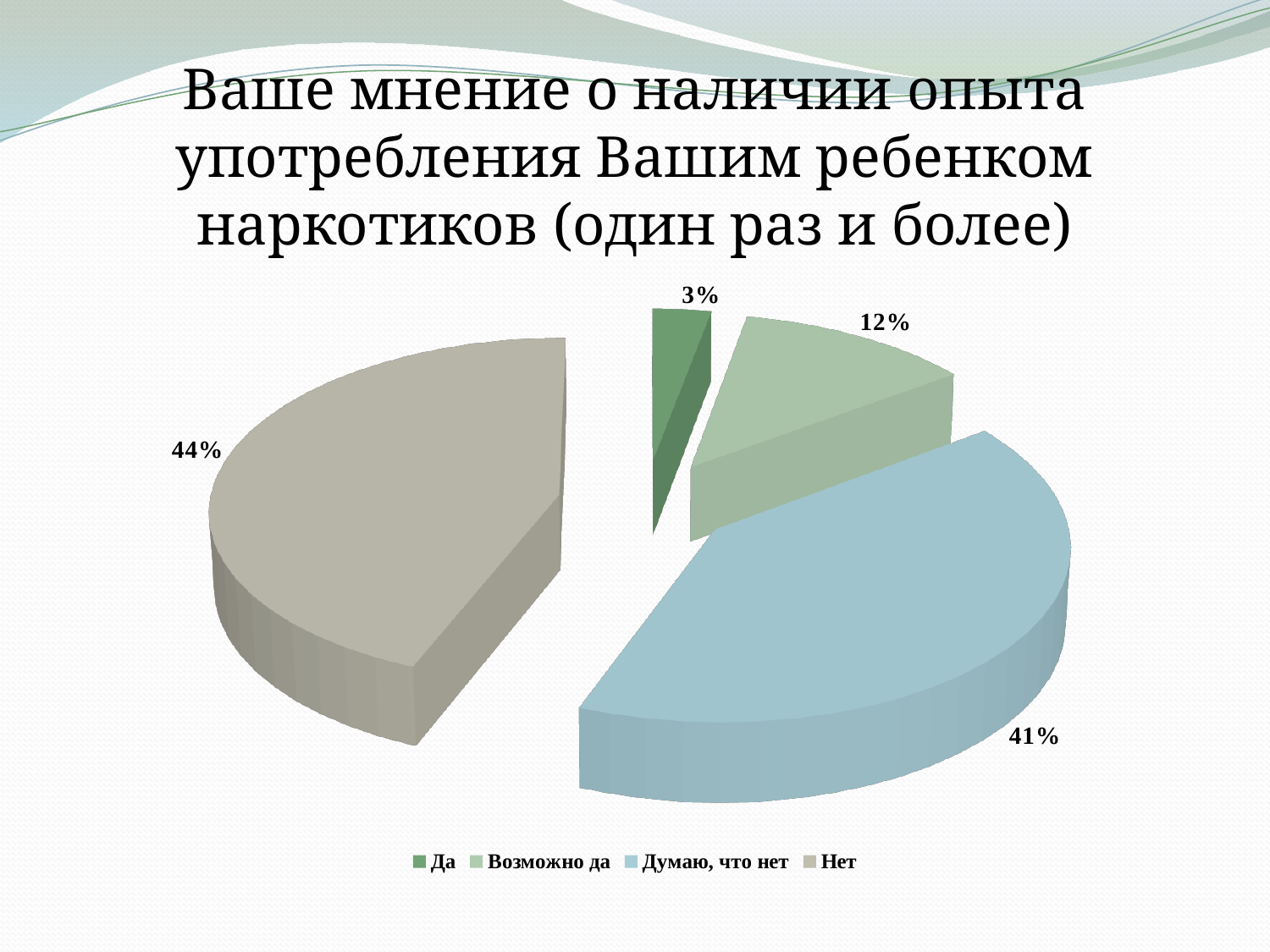
What share of the pie does the 'Возможно да' slice represent? 12% How many categories does the legend list? 4 What is the difference in percentage points between the 'Возможно да' and 'Да' slices? 9% Which category has the smallest slice of the pie? Да What share of the pie does the 'Думаю, что нет' slice represent? 41% What colour is the 'Думаю, что нет' slice? light blue Which is larger, the 'Возможно да' slice or the 'Да' slice? Возможно да What share of the pie does the 'Нет' slice represent? 44% What is the difference in percentage points between the 'Нет' and 'Думаю, что нет' slices? 3% What kind of chart is shown on the slide? pie chart Which category has the largest slice of the pie? Нет